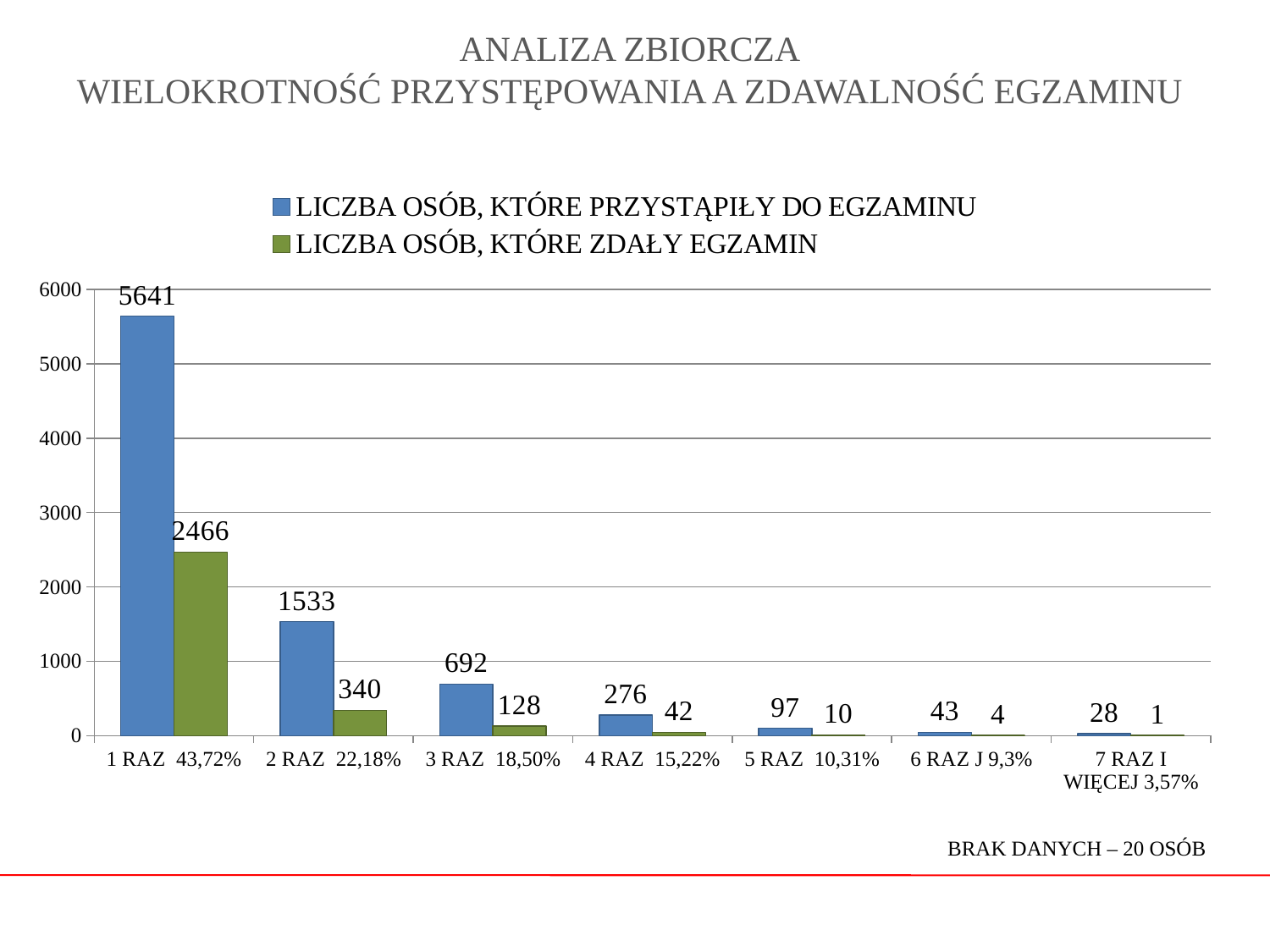
How many people passed the exam in the 2 RAZ 22,18% category (LICZBA OSÓB, KTÓRE ZDAŁY EGZAMIN)? 340 Which is larger: the number of people who passed in the 1 RAZ 43,72% category or the number who took the exam in the 2 RAZ 22,18% category? 1 RAZ 43,72% passed (2466) How many series does the legend list? 2 How many people took the exam for the first time (1 RAZ 43,72%) according to the LICZBA OSÓB, KTÓRE PRZYSTĄPIŁY DO EGZAMINU series? 5641 What is the value of LICZBA OSÓB, KTÓRE ZDAŁY EGZAMIN for the 7 RAZ I WIĘCEJ 3,57% category? 1 How many categories are shown on the x axis? 7 What kind of chart is shown on the slide? Bar chart What is the value of LICZBA OSÓB, KTÓRE PRZYSTĄPIŁY DO EGZAMINU for the 4 RAZ 15,22% category? 276 Which category has the lowest value for LICZBA OSÓB, KTÓRE ZDAŁY EGZAMIN? 7 RAZ I WIĘCEJ 3,57% What is the difference between the number of people who took the exam and the number who passed in the 3 RAZ 18,50% category? 564 Do the values for LICZBA OSÓB, KTÓRE PRZYSTĄPIŁY DO EGZAMINU rise or fall from left to right along the x axis? Fall Which category has the highest value for LICZBA OSÓB, KTÓRE PRZYSTĄPIŁY DO EGZAMINU? 1 RAZ 43,72%